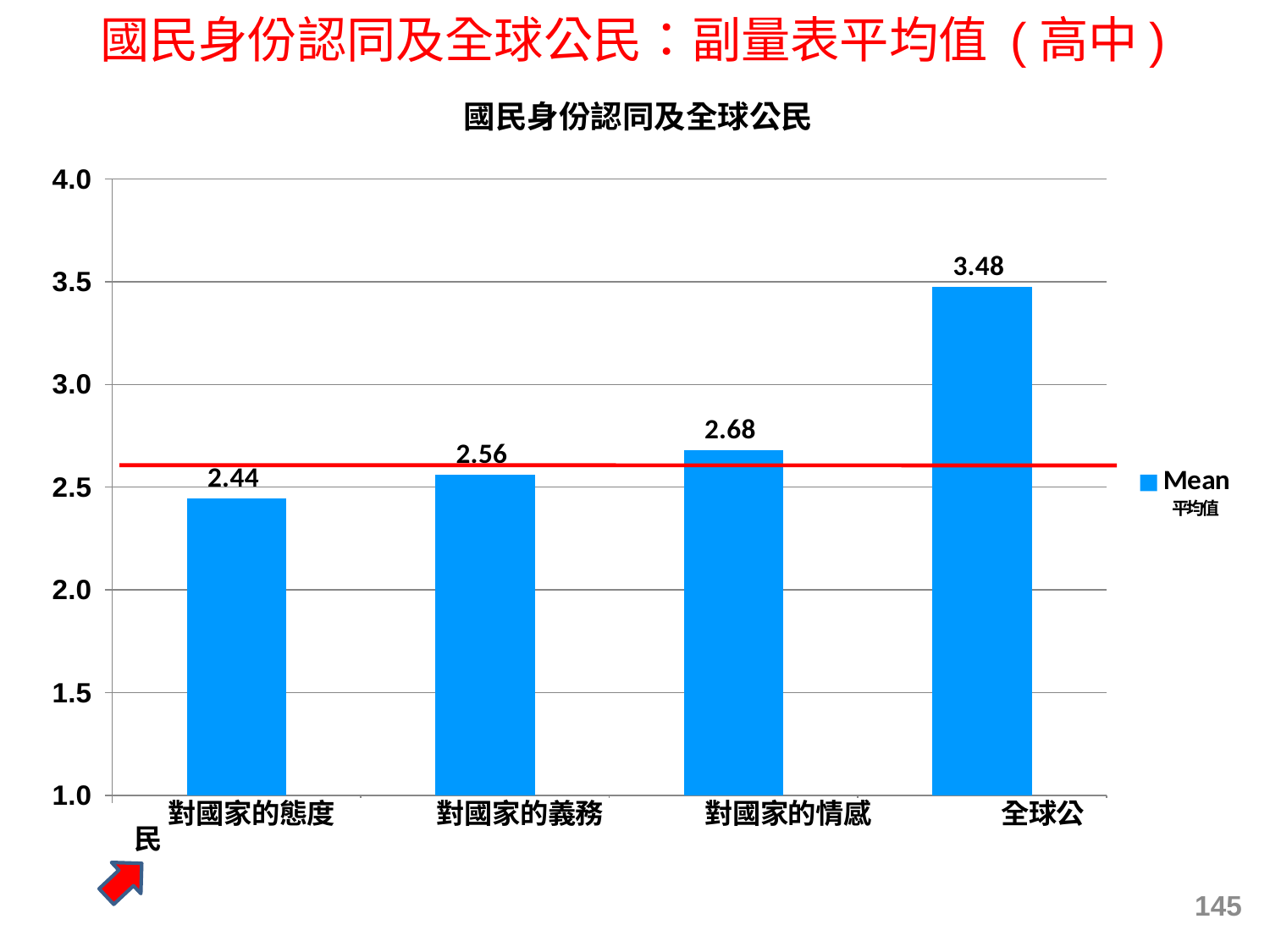
What is the difference between the Mean values for 全球公民 and 對國家的態度? 1.04 What is the title of the chart? 國民身份認同及全球公民 Which category has the highest Mean value? 全球公民 What is the difference between the Mean values for 對國家的情感 and 對國家的義務? 0.12 What kind of chart is shown on the slide? Bar chart What is the Mean value for 對國家的情感? 2.68 Which category has the lowest Mean value? 對國家的態度 How many categories are shown on the x axis? 4 What is the Mean value for 對國家的義務? 2.56 Which has a larger Mean value, 對國家的義務 or 對國家的情感? 對國家的情感 What is the Mean value for 對國家的態度? 2.44 What is the Mean value for 全球公民? 3.48